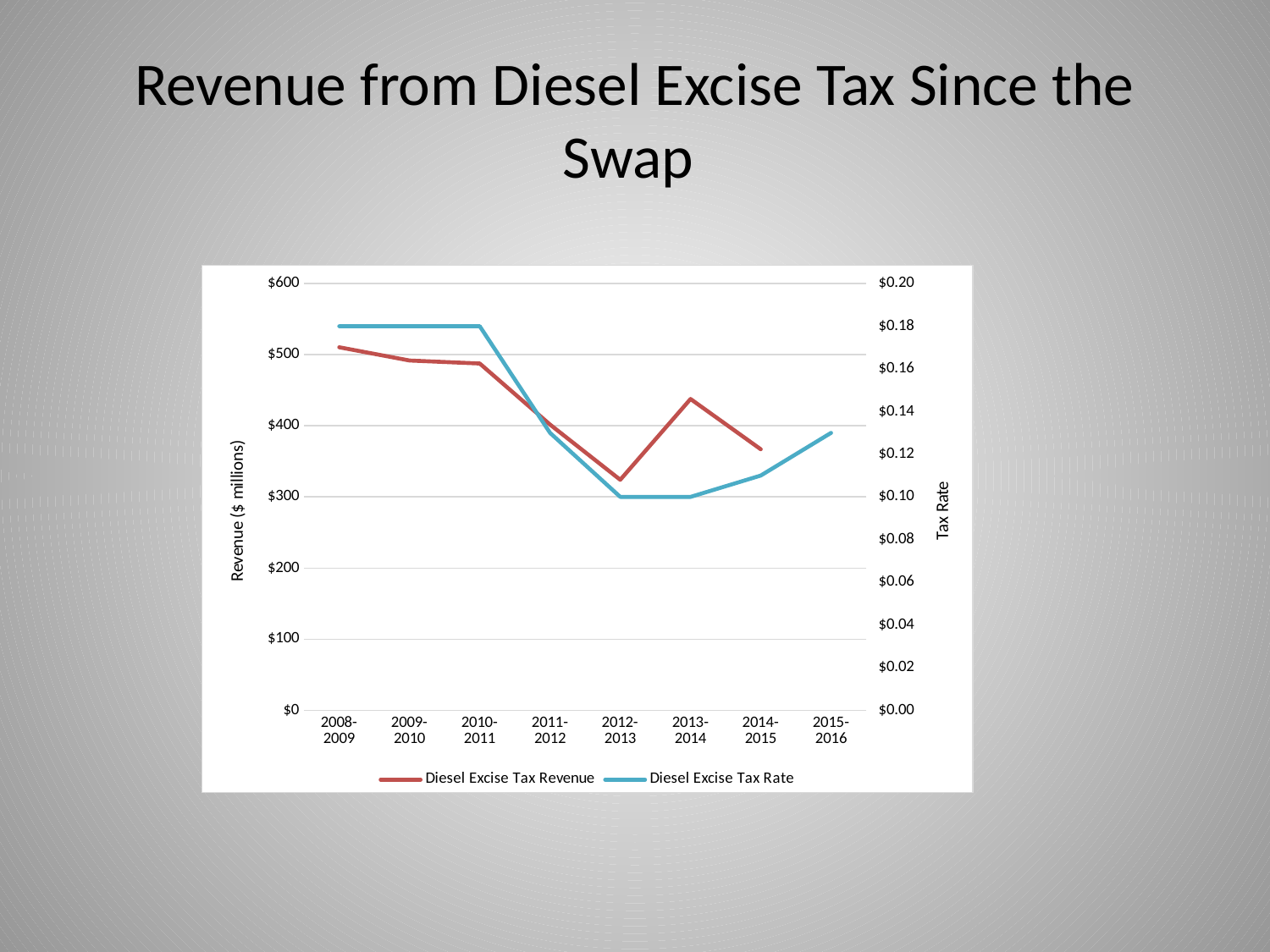
In which fiscal year is Diesel Excise Tax Revenue highest? 2008-2009 Is the Diesel Excise Tax Revenue for 2008-2009 greater or less than $500? greater What kind of chart is shown on the slide? Line chart Is the Diesel Excise Tax Revenue for 2014-2015 greater or less than $400? less What is the title of the left vertical axis? Revenue ($ millions) What is the Diesel Excise Tax Rate in 2008-2009? $0.18 How many series does the legend list? 2 What is the Diesel Excise Tax Rate in 2012-2013? $0.10 In which fiscal year is Diesel Excise Tax Revenue lowest? 2012-2013 Which is larger, the Diesel Excise Tax Revenue in 2013-2014 or in 2014-2015? 2013-2014 Does Diesel Excise Tax Revenue rise or fall from 2008-2009 to 2012-2013? Fall How many fiscal-year categories are shown on the x axis? 8